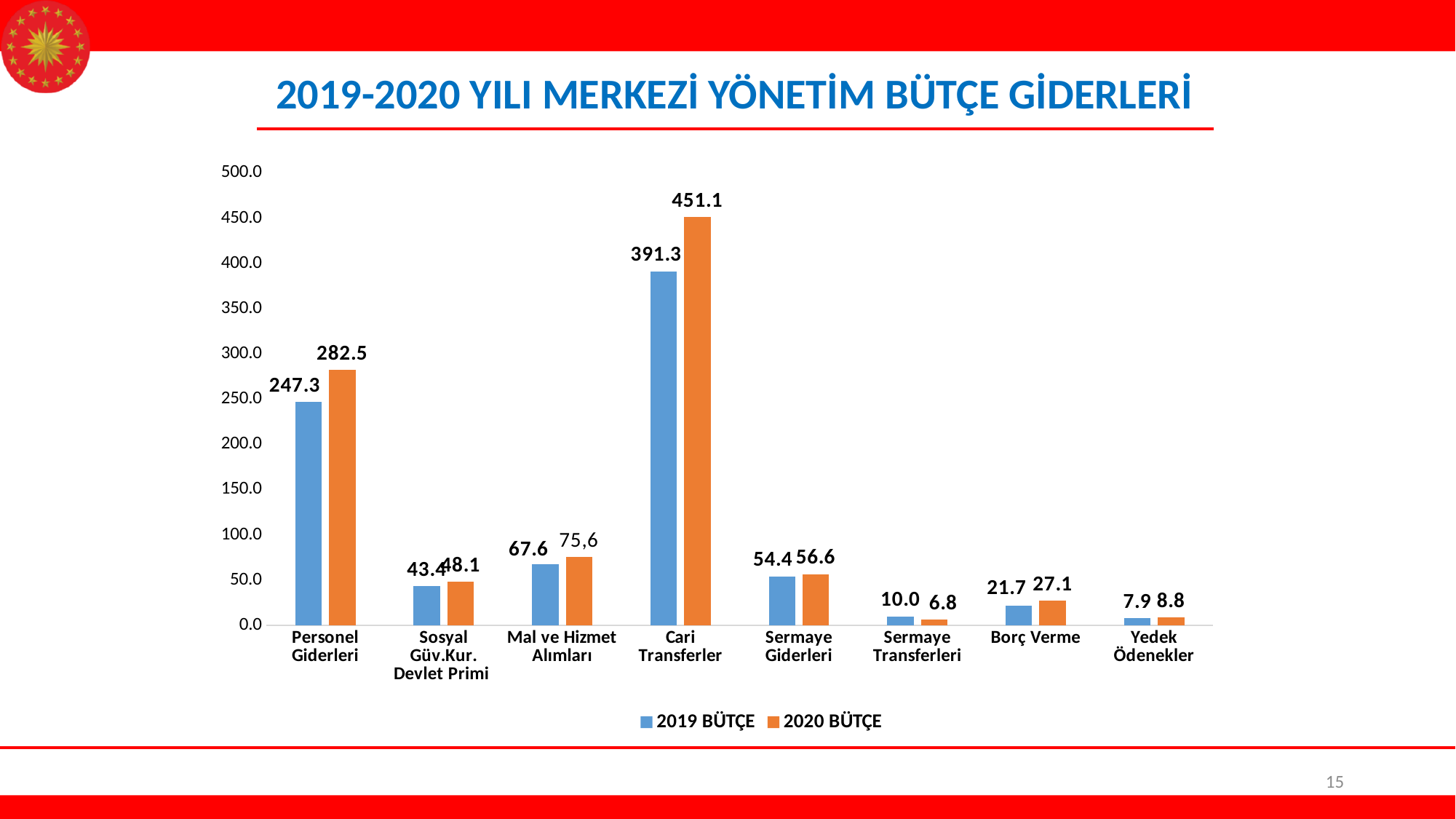
How many series does the legend list? 2 What is the difference between the 2020 BÜTÇE and 2019 BÜTÇE values for Cari Transferler? 59.8 How many categories are shown on the x axis? 8 Which category has the lowest 2019 BÜTÇE value? Yedek Ödenekler What is the 2020 BÜTÇE value for Mal ve Hizmet Alımları? 75,6 What is the difference between the 2020 BÜTÇE and 2019 BÜTÇE values for Personel Giderleri? 35.2 What kind of chart is shown on the slide? Bar chart What is the 2020 BÜTÇE value for Cari Transferler? 451.1 What is the 2019 BÜTÇE value for Personel Giderleri? 247.3 Which category has the highest 2020 BÜTÇE value? Cari Transferler What is the 2019 BÜTÇE value for Sermaye Transferleri? 10.0 For Sermaye Transferleri, which is larger: the 2019 BÜTÇE value or the 2020 BÜTÇE value? 2019 BÜTÇE